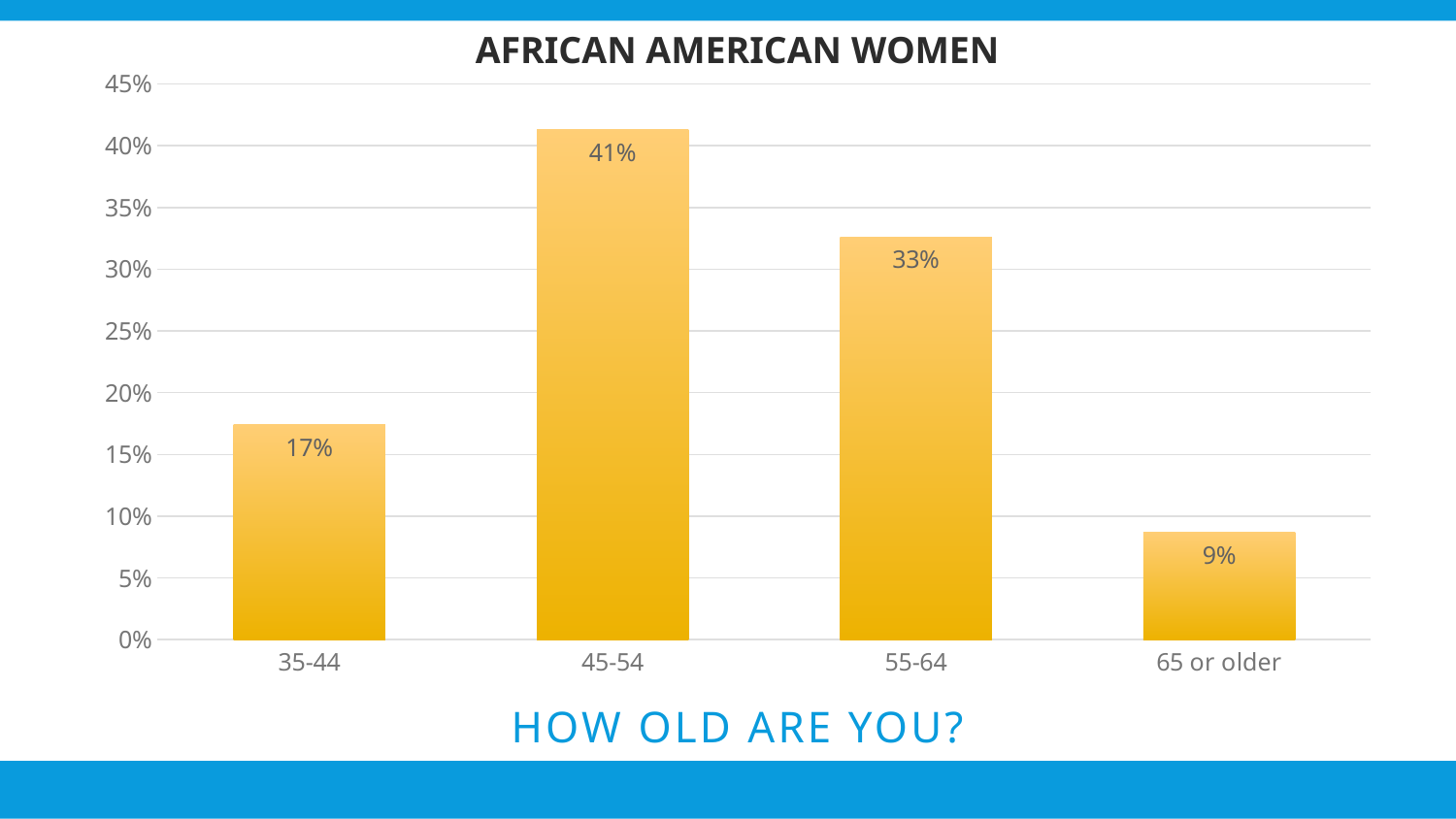
What is the value shown for the 65 or older age group? 9% Which age group has a larger value, 35-44 or 55-64? 55-64 What is the title of the chart? AFRICAN AMERICAN WOMEN Which age group has the highest percentage? 45-54 What percentage of African American women are aged 45-54? 41% Which age group has the lowest percentage? 65 or older Is the value for the 55-64 age group greater or less than 30%? greater What type of chart is shown on the slide? Bar chart How many age groups are shown on the chart? 4 What is the value shown for the 35-44 age group? 17% What question is written below the chart's x axis? HOW OLD ARE YOU? What is the difference in percentage points between the 45-54 and 55-64 age groups? 8